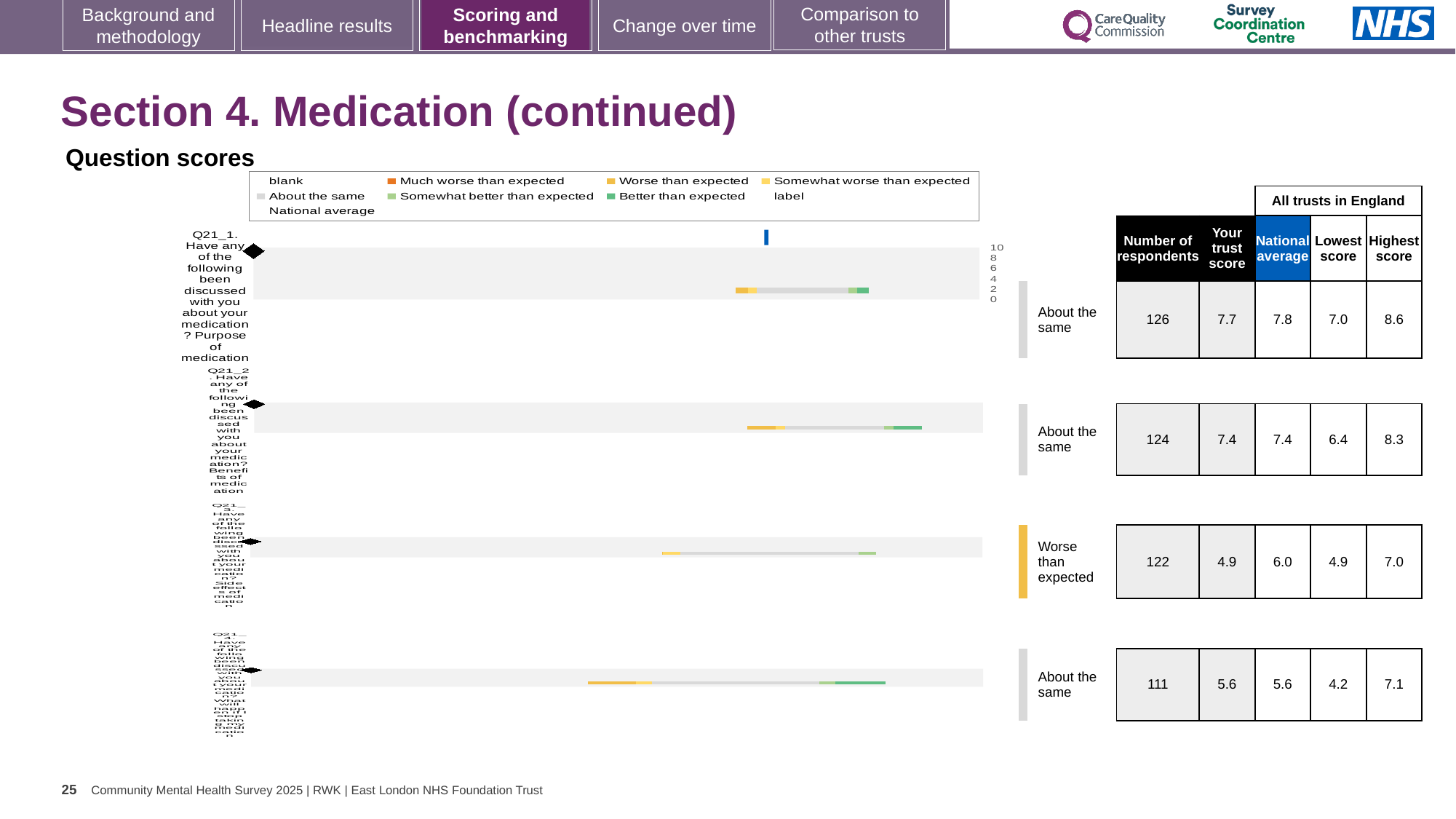
Which question has the highest trust score? Q21_1 What kind of chart is used to show the question scores on this slide? bar chart Which question is rated 'Worse than expected'? Q21_3 Which question has the lowest trust score? Q21_3 Which has the higher trust score, Q21_1 or Q21_4? Q21_1 What is the lowest score across all trusts in England for Q21_2 (Benefits of medication)? 6.4 How many respondents answered Q21_4 (What might happen if you stop taking medication)? 111 How many questions (bars) are plotted in the question scores chart? 4 What is the difference between the highest score and the lowest score for Q21_1? 1.6 What is the difference between the national average and the trust score for Q21_3? 1.1 What is the national average for Q21_3 (Side effects of medication)? 6.0 What is the trust score for Q21_1 (Purpose of medication)? 7.7